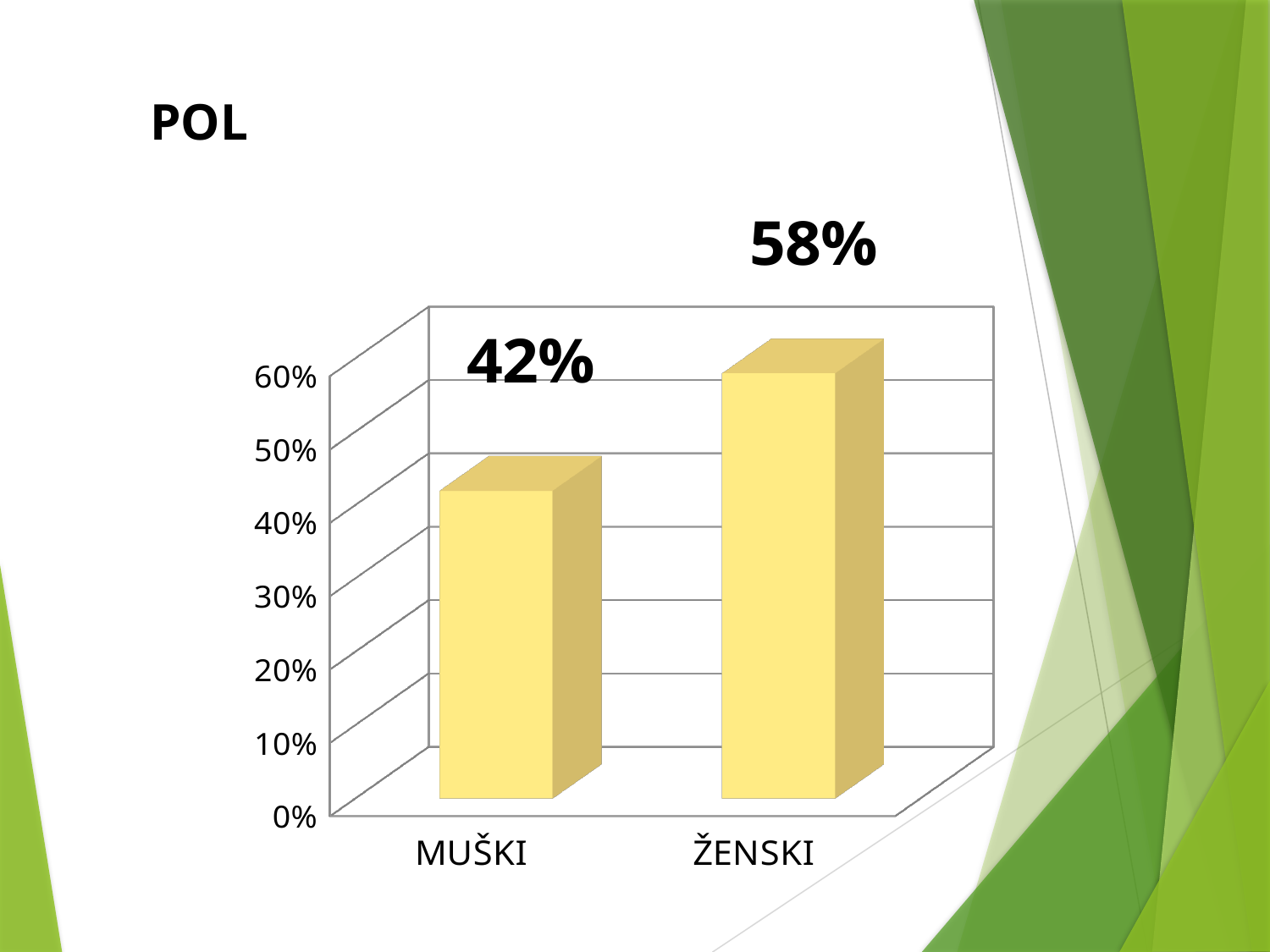
Is the value for ŽENSKI greater or less than 50%? greater What is the title of the slide above the chart? POL What kind of chart is shown on the slide? bar chart Which is larger, the value for MUŠKI or the value for ŽENSKI? ŽENSKI Which category has the lowest value? MUŠKI How many categories are shown on the x axis? 2 What is the value for MUŠKI? 42% What is the difference between the values for ŽENSKI and MUŠKI? 16% Which category has the highest value? ŽENSKI Is the value for MUŠKI greater or less than 50%? less What is the value for ŽENSKI? 58% What is the highest value shown on the vertical axis? 60%